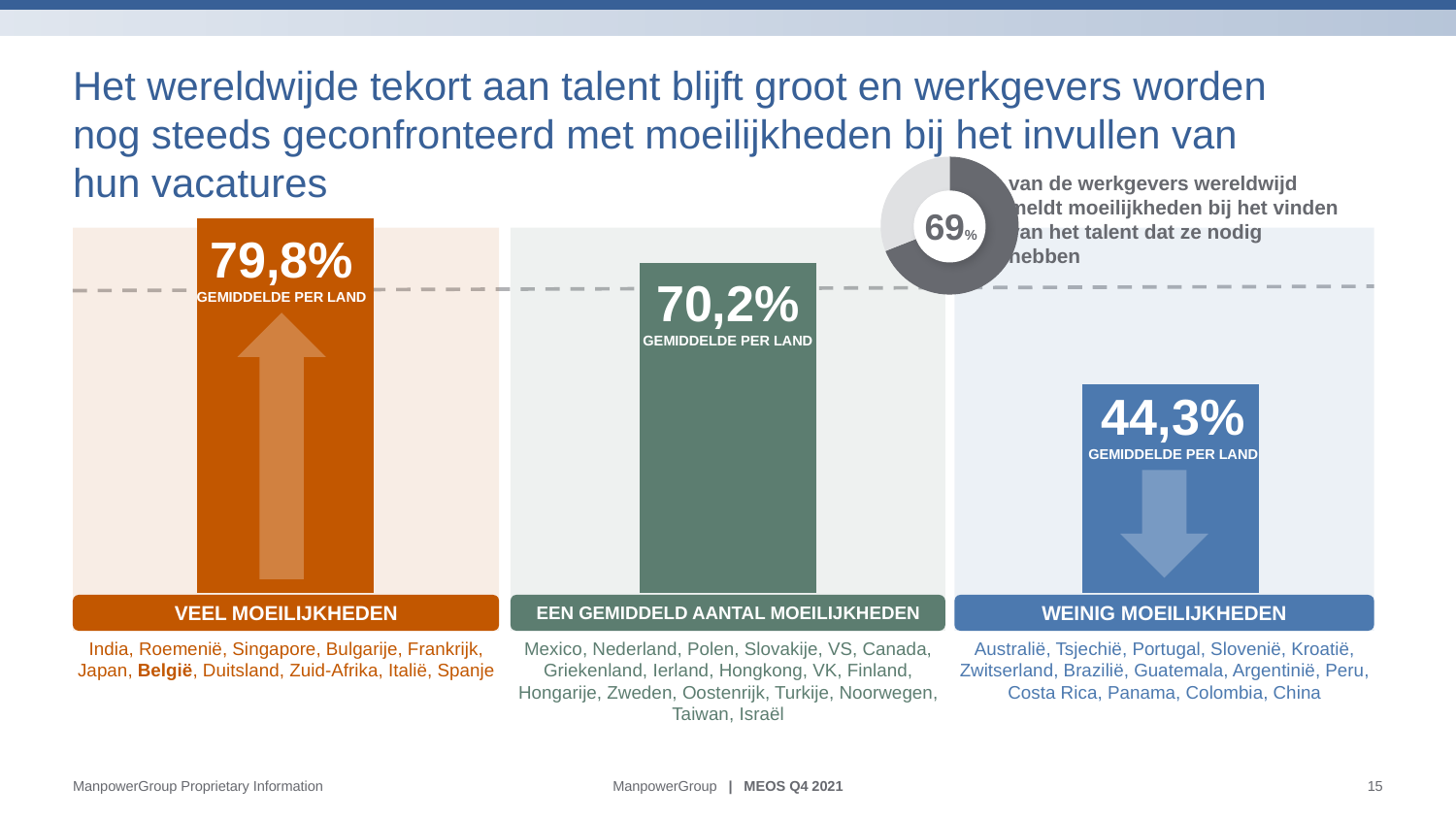
In the bar chart, what is the difference between the 'VEEL MOEILIJKHEDEN' and 'WEINIG MOEILIJKHEDEN' values? 35,5% In the bar chart, do the values rise or fall from left to right? Fall In the bar chart, which category has the highest average per country? VEEL MOEILIJKHEDEN In the bar chart, which category has the lowest average per country? WEINIG MOEILIJKHEDEN What kind of chart shows the three 'GEMIDDELDE PER LAND' values? Bar chart How many categories does the bar chart show? 3 In the bar chart, what is the difference between the 'VEEL MOEILIJKHEDEN' and 'EEN GEMIDDELD AANTAL MOEILIJKHEDEN' values? 9,6% In the bar chart, what is the average per country for the 'VEEL MOEILIJKHEDEN' category? 79,8% In the bar chart, which is larger: the value for 'EEN GEMIDDELD AANTAL MOEILIJKHEDEN' or for 'WEINIG MOEILIJKHEDEN'? EEN GEMIDDELD AANTAL MOEILIJKHEDEN In the donut chart at the top right, what percentage of employers worldwide report difficulties finding the talent they need? 69% In the bar chart, what is the average per country for the 'WEINIG MOEILIJKHEDEN' category? 44,3% In the bar chart, what is the average per country for the 'EEN GEMIDDELD AANTAL MOEILIJKHEDEN' category? 70,2%